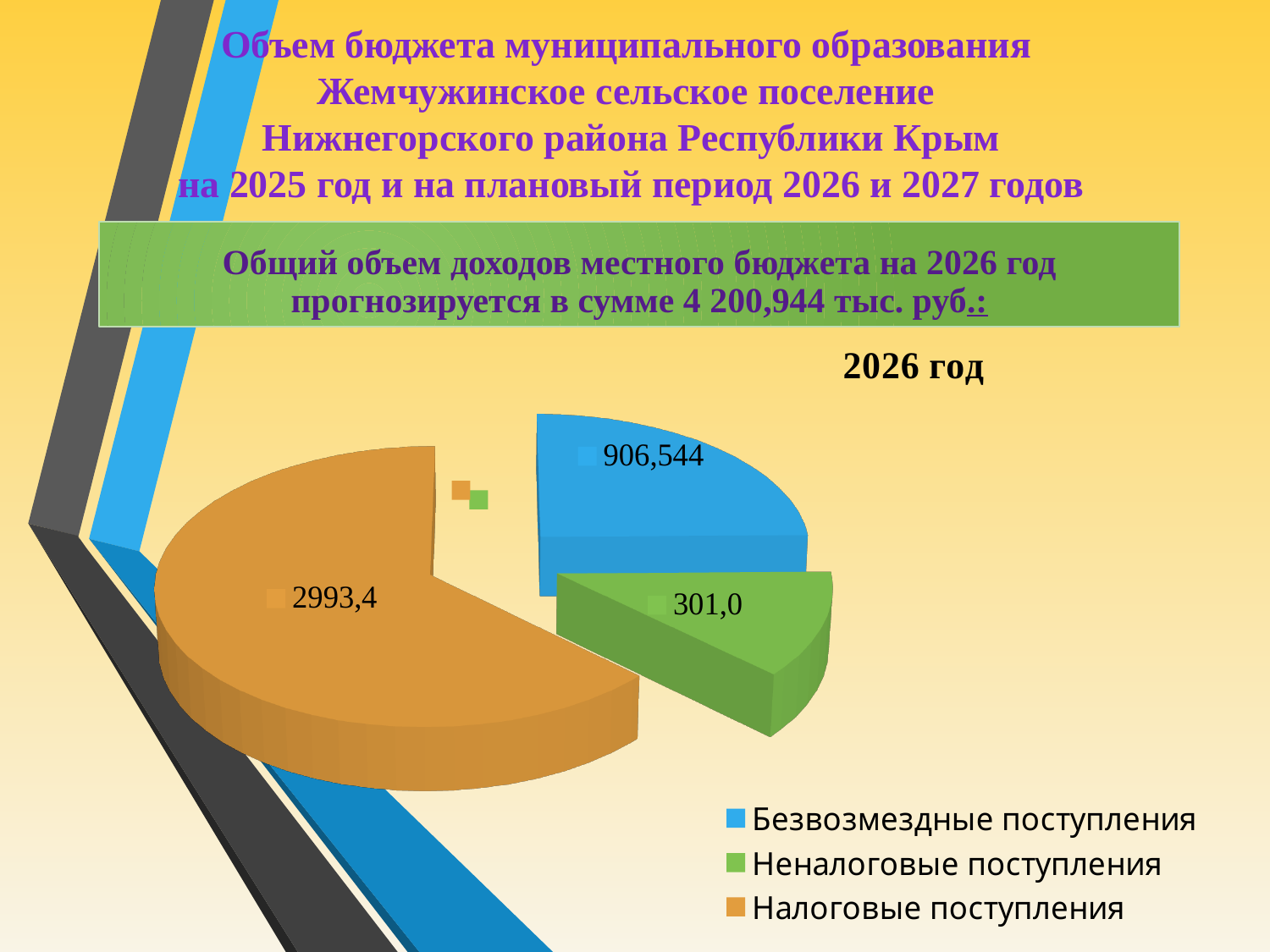
Which is larger in the 2026 год pie chart: Безвозмездные поступления or Неналоговые поступления? Безвозмездные поступления What is the difference between Налоговые поступления and Безвозмездные поступления in the 2026 год pie chart? 2086,856 Which category has the largest slice in the 2026 год pie chart? Налоговые поступления How many entries does the legend of the pie chart list? 3 What is the value for Безвозмездные поступления in the 2026 год pie chart? 906,544 What is the value for Неналоговые поступления in the 2026 год pie chart? 301,0 What is the difference between Безвозмездные поступления and Неналоговые поступления in the 2026 год pie chart? 605,544 Which category has the smallest slice in the 2026 год pie chart? Неналоговые поступления What kind of chart is shown on the slide? pie chart How many slices does the 2026 год pie chart have? 3 What colour is the slice for Безвозмездные поступления in the pie chart? blue What is the value for Налоговые поступления in the 2026 год pie chart? 2993,4